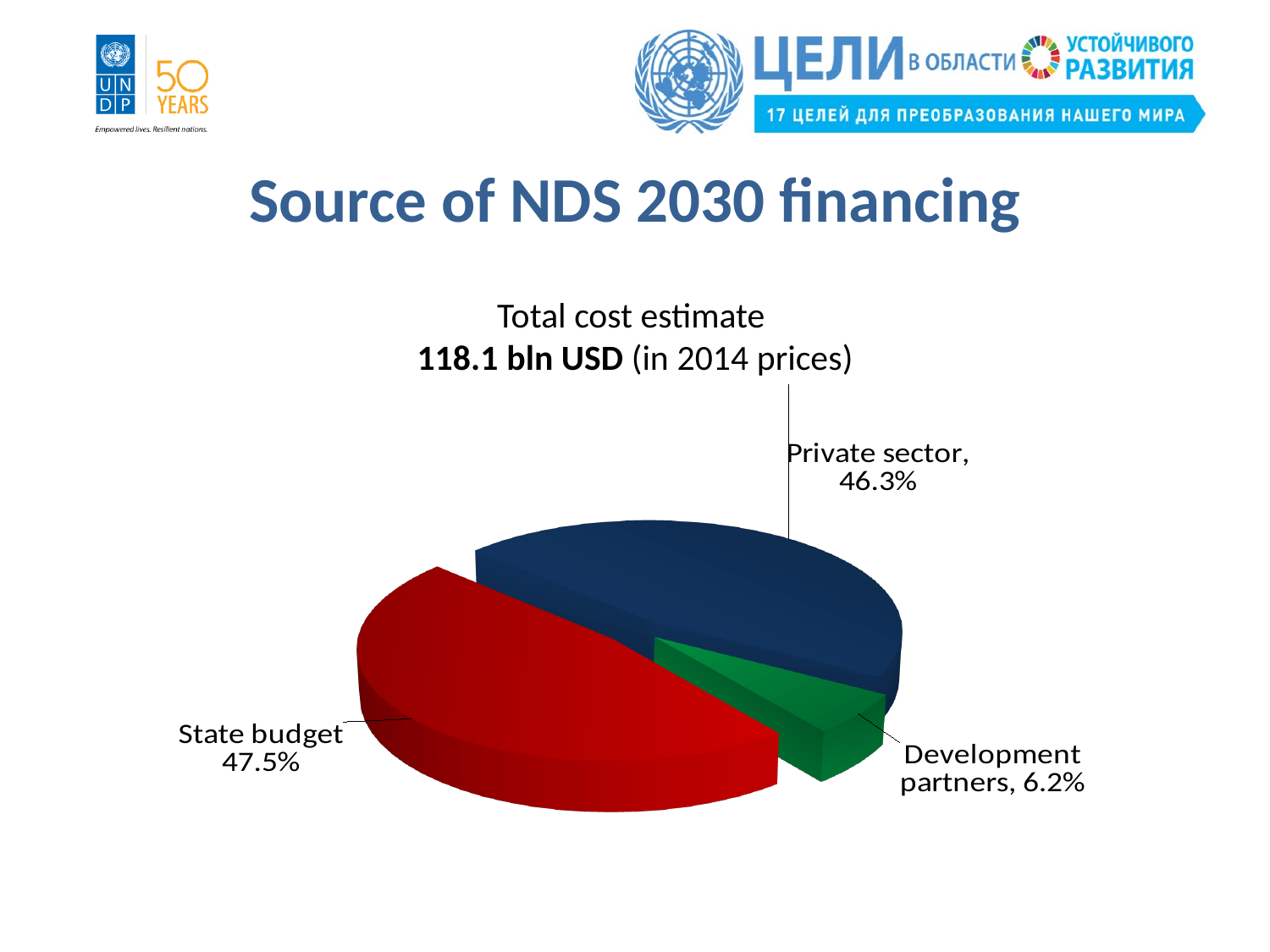
Which financing source has the largest share of the pie? State budget What colour is the state budget slice? Red How many slices does the pie chart have? 3 Which is larger: the private sector share or the development partners share? Private sector What is the difference in percentage points between the private sector share and the development partners share? 40.1 What is the difference in percentage points between the state budget share and the private sector share? 1.2 What is the total cost estimate stated above the chart? 118.1 bln USD (in 2014 prices) What share of NDS 2030 financing comes from the state budget? 47.5% What kind of chart is shown on the slide? Pie chart Which financing source has the smallest share of the pie? Development partners What share of NDS 2030 financing comes from the private sector? 46.3% What share of NDS 2030 financing comes from development partners? 6.2%